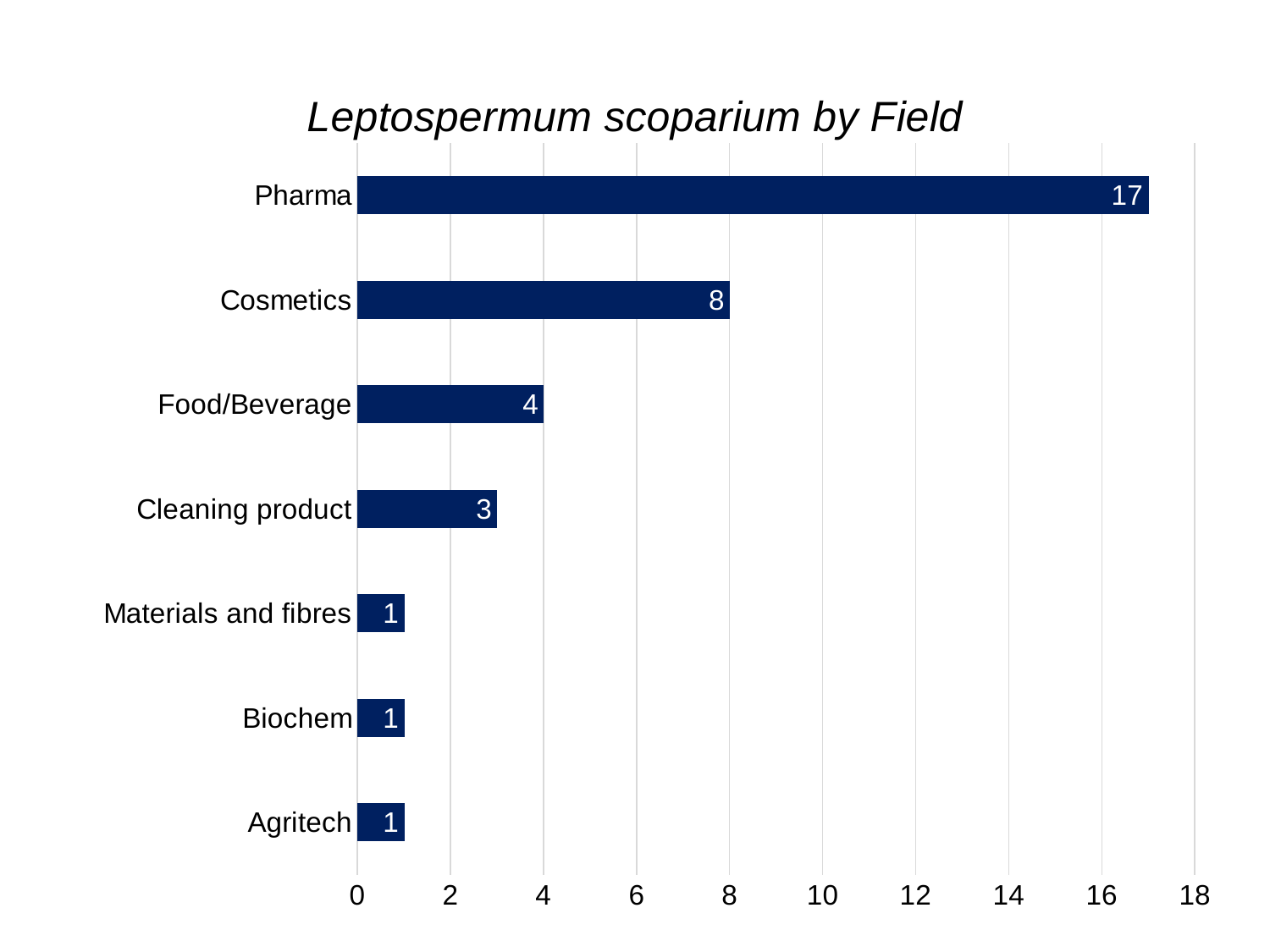
What is the value for Food/Beverage? 4 How many fields are shown in the chart? 7 What is the value for Pharma? 17 What is the difference between the values for Food/Beverage and Cleaning product? 1 What kind of chart is shown on the slide? bar chart What is the title of the chart? Leptospermum scoparium by Field Which is larger, the value for Cosmetics or the value for Food/Beverage? Cosmetics Is the value for Pharma greater or less than 10? greater What is the difference between the values for Pharma and Cosmetics? 9 What is the value for Cosmetics? 8 Which field has the highest value? Pharma What is the value for Cleaning product? 3